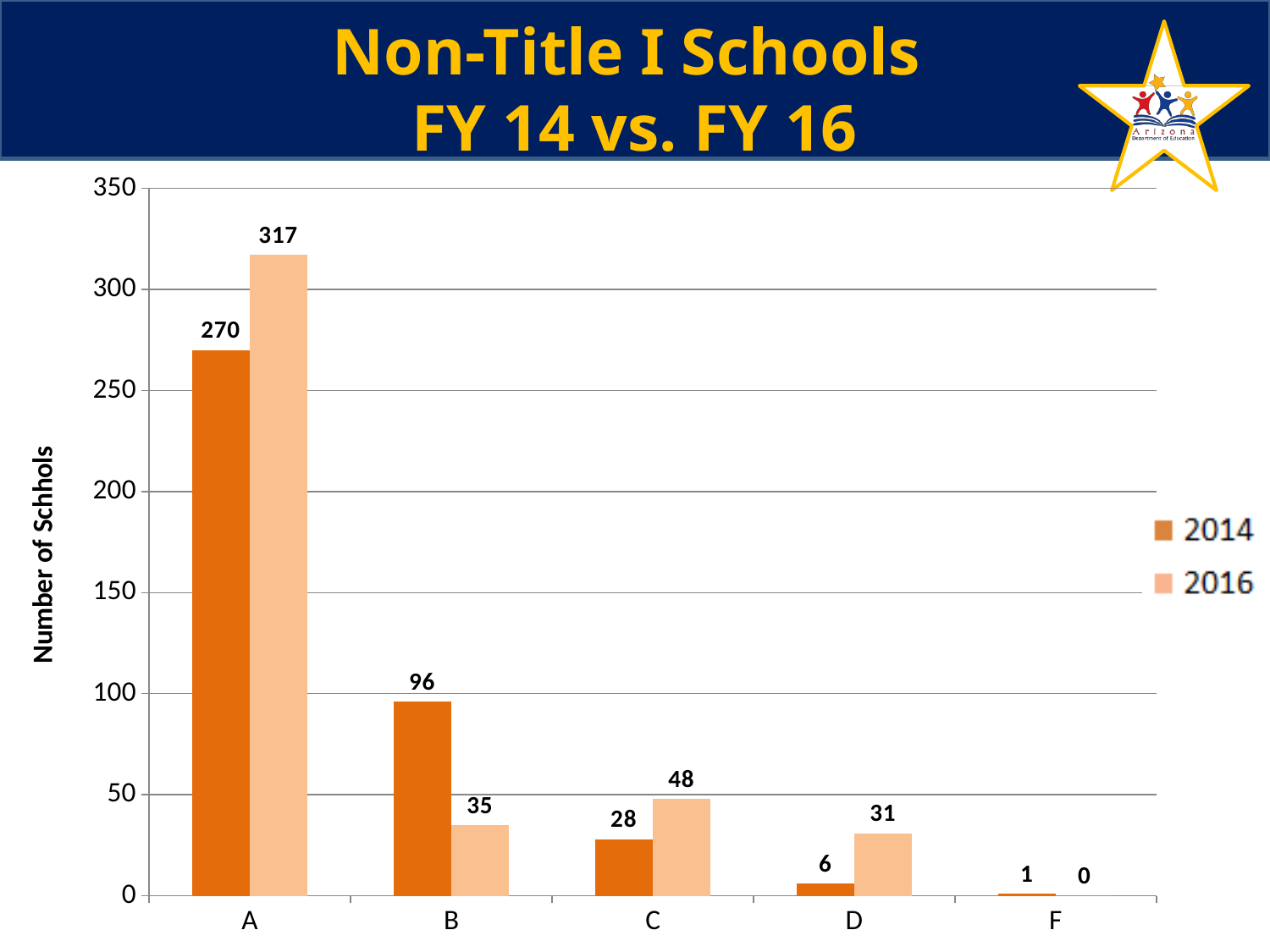
Which is larger for grade C, the 2014 value or the 2016 value? 2016 What is the value for grade A in the 2014 series? 270 How many series does the legend list? 2 Which category has the highest value in the 2016 series? A What is the value for grade B in the 2016 series? 35 What is the difference between the 2016 and 2014 values for grade A? 47 What is the label of the y axis? Number of Schhols What is the value for grade D in the 2014 series? 6 How many categories are shown on the x axis? 5 What is the difference between the 2014 and 2016 values for grade B? 61 What kind of chart is shown on the slide? Bar chart Which category has the lowest value in the 2014 series? F